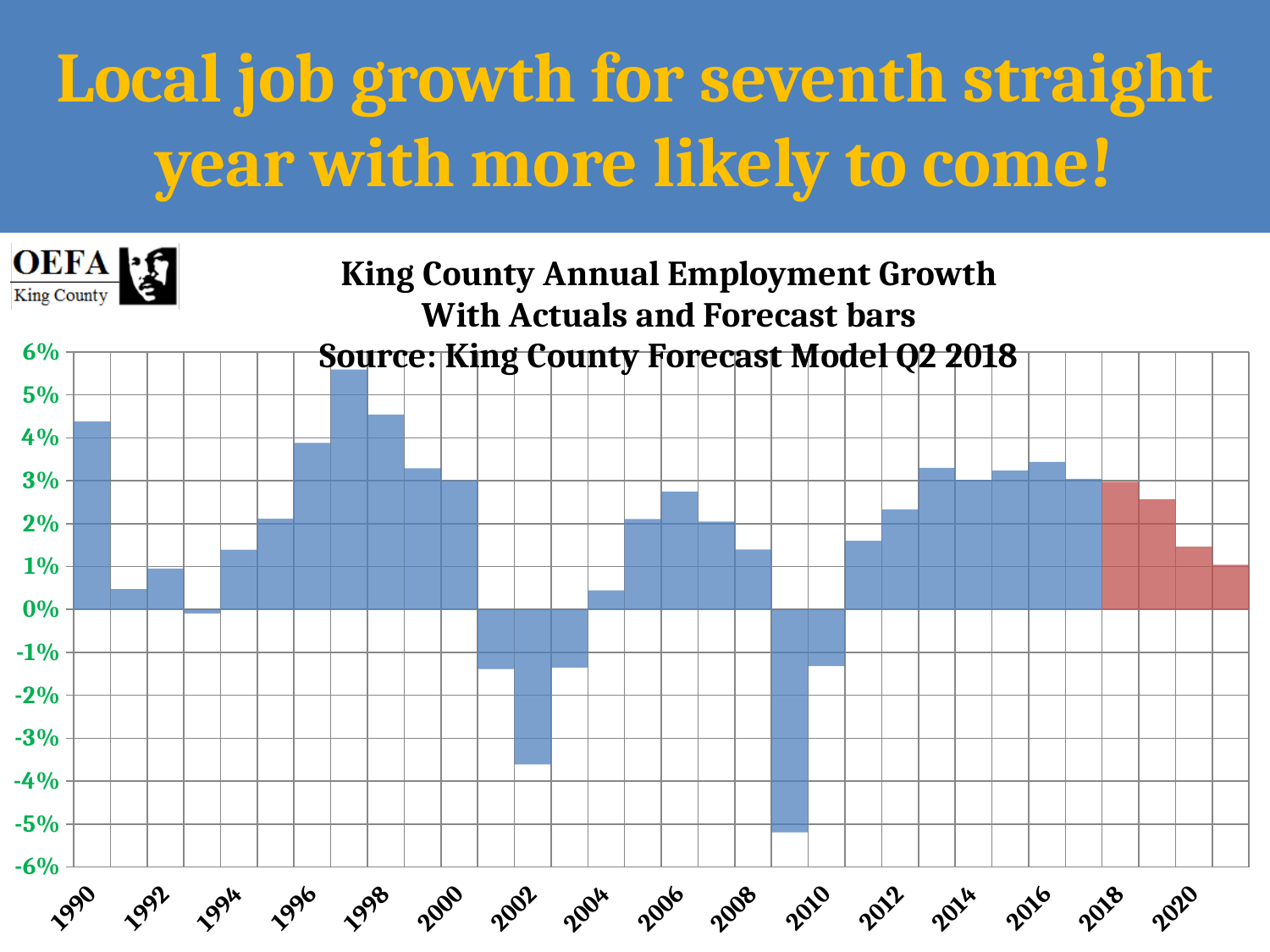
Is the value for 1990 greater or less than 4%? greater Is the value for 2002 greater or less than -3%? less Which year has the larger employment growth, 1997 or 1998? 1997 Which year has the lowest employment growth in the chart? 2009 Is the value for 2020 greater or less than 2%? less What kind of chart is shown on the slide? Bar chart Do the forecast bars rise or fall from 2018 to the last bar on the right? Fall How many red (forecast) bars are shown in the chart? 4 According to the chart title, what is the source of the data? King County Forecast Model Q2 2018 Which year has the highest employment growth in the chart? 1997